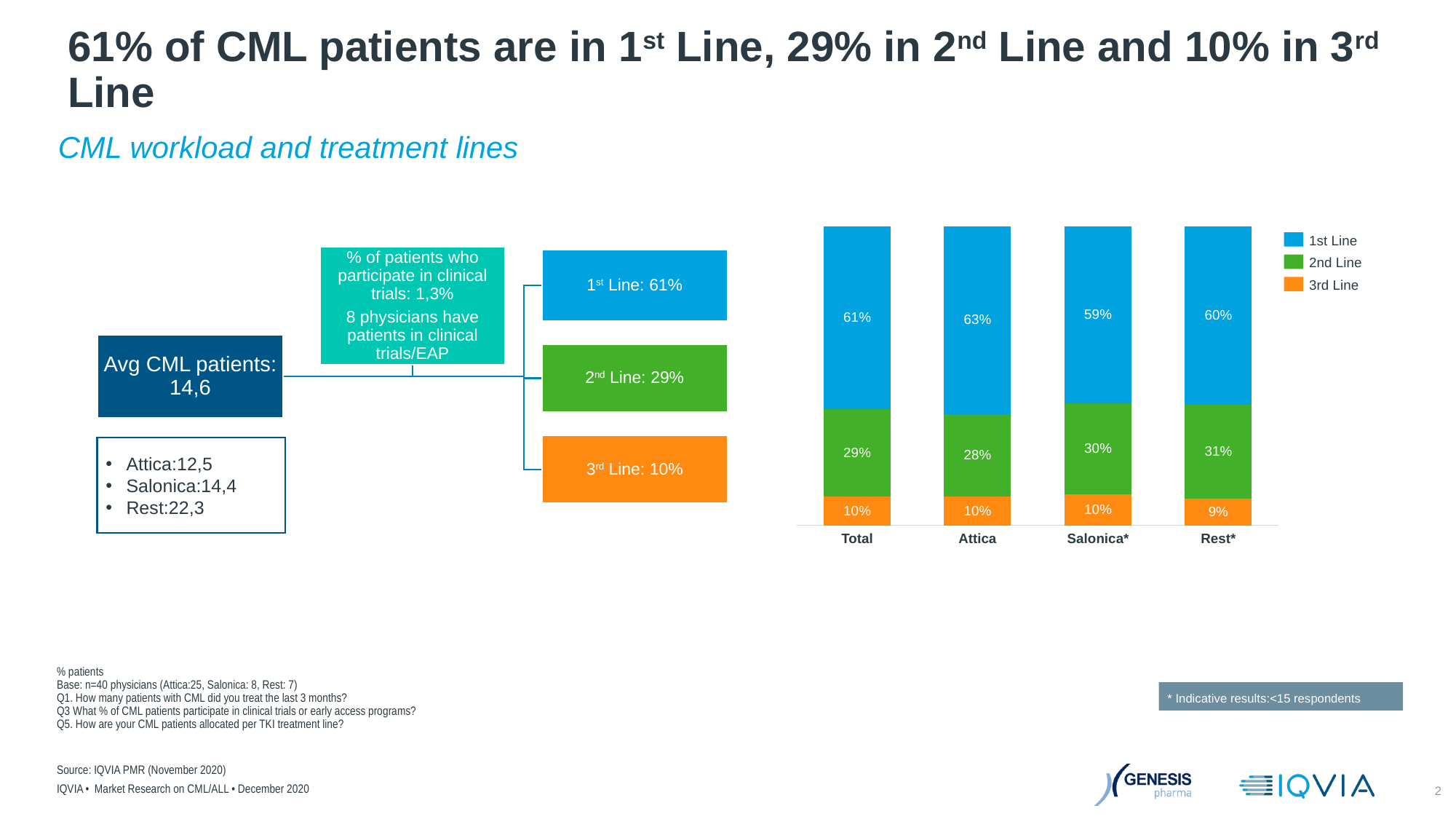
Is the 2nd Line value larger for Rest* or for Attica in the stacked bar chart? Rest* What is the 2nd Line value for Rest* in the stacked bar chart? 31% How many series does the legend of the stacked bar chart list? 3 What is the difference between the 1st Line values for Attica and Salonica* in the stacked bar chart? 4% How many categories are shown on the x axis of the stacked bar chart? 4 What is the 3rd Line value for Rest* in the stacked bar chart? 9% Which category has the lowest 3rd Line value in the stacked bar chart? Rest* What type of chart is shown on the right of the slide? Stacked bar chart Which colour represents 3rd Line in the stacked bar chart legend? Orange Which category has the highest 1st Line value in the stacked bar chart? Attica What is the 1st Line value for Attica in the stacked bar chart? 63% What is the 2nd Line value for Salonica* in the stacked bar chart? 30%